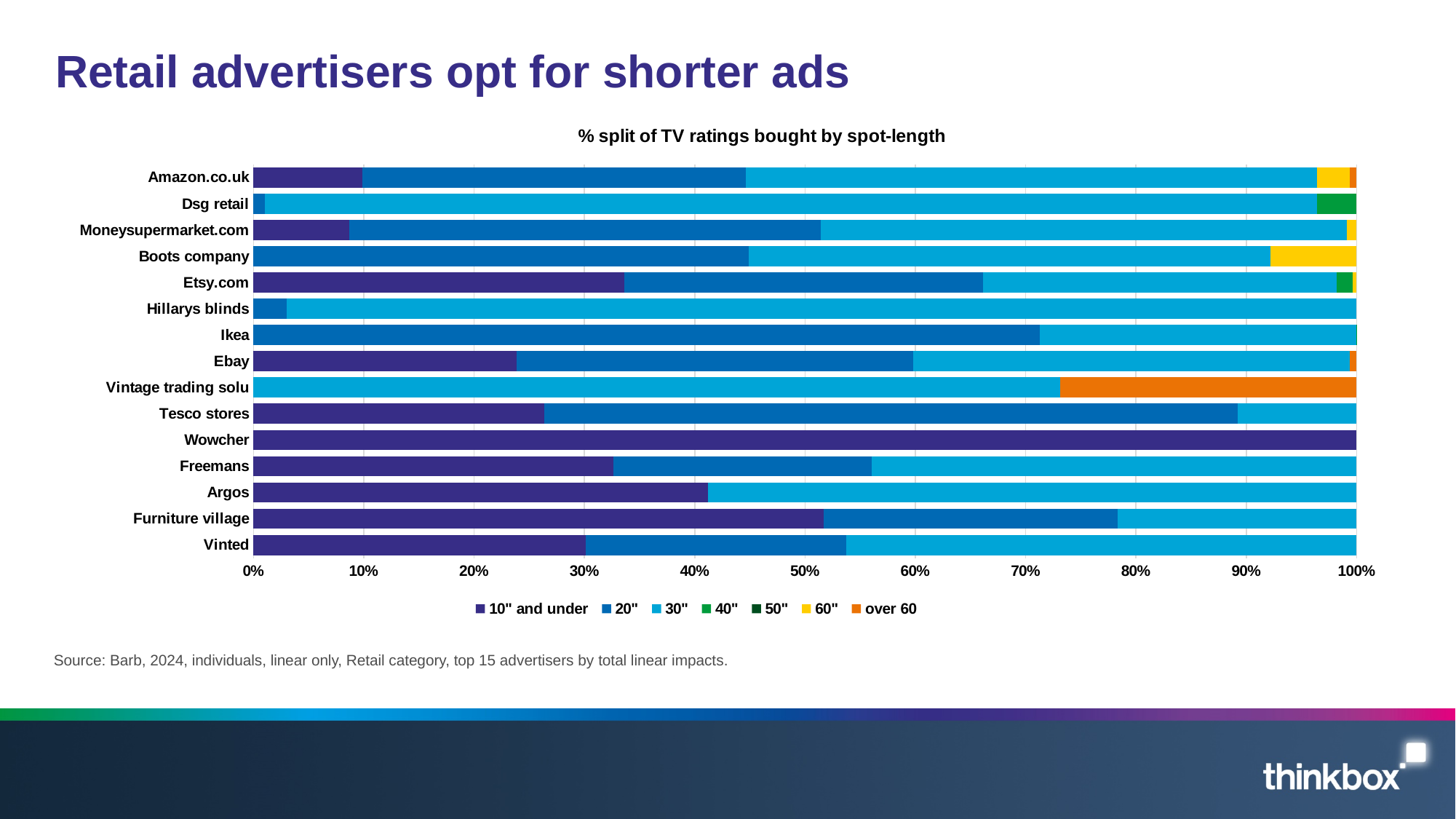
How many spot-length series does the legend list? 7 Is the 10" and under share for Tesco stores greater or less than 30%? less Which has the larger 10" and under share, Etsy.com or Ebay? Etsy.com Which has the larger 10" and under share, Furniture village or Argos? Furniture village What share of Wowcher's TV ratings were bought at 10" and under? 100% How many advertisers are listed on the chart? 15 Is the over 60 share for Vintage trading solu greater or less than 20%? greater What is the title of the chart? % split of TV ratings bought by spot-length What kind of chart is shown on the slide? Stacked bar chart Which advertiser has the largest share of TV ratings bought at 60"? Boots company Which advertiser has the largest share of TV ratings bought at over 60 seconds? Vintage trading solu Which advertiser has the largest share of TV ratings bought at 10" and under? Wowcher